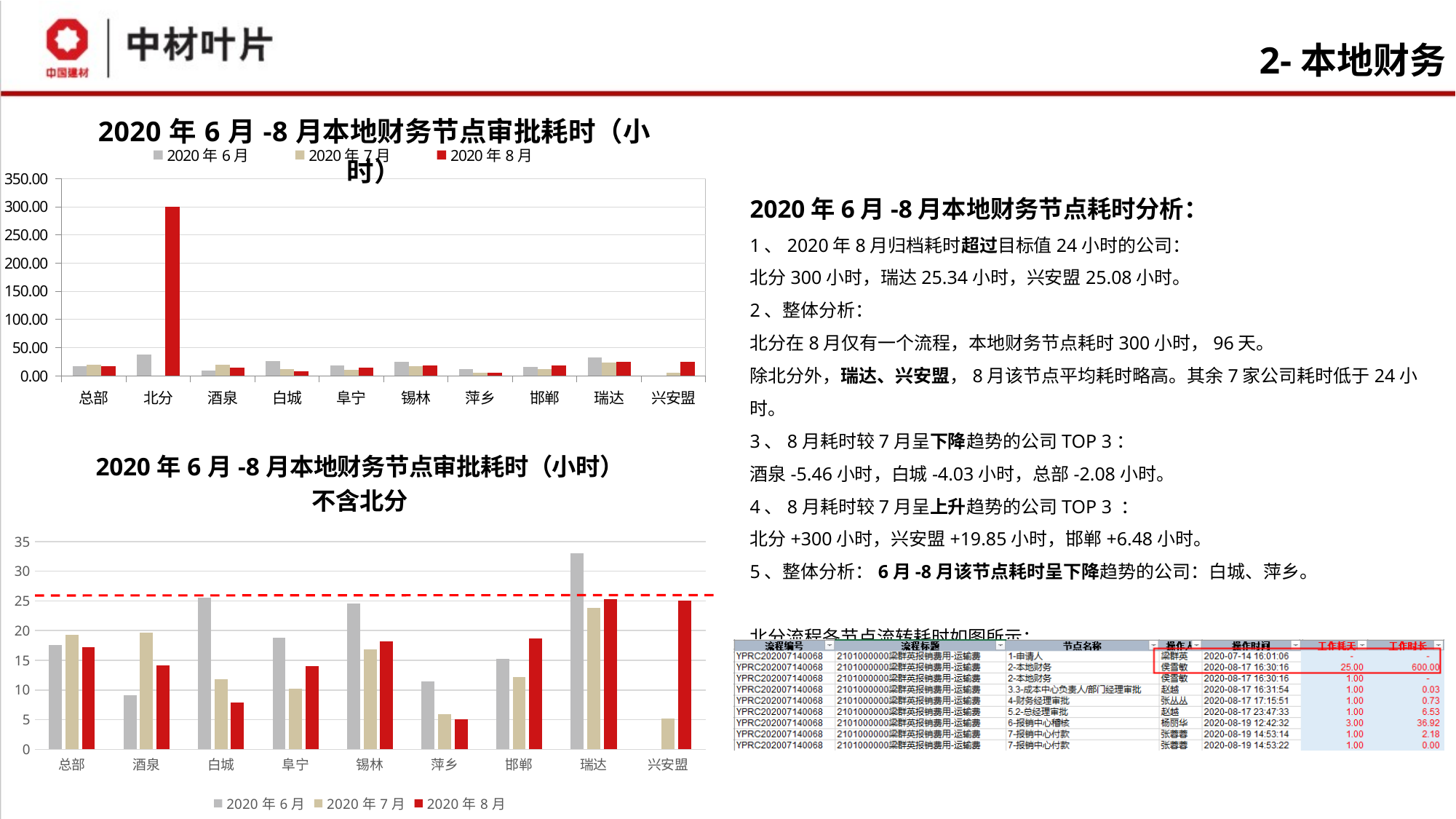
How many categories are shown on the x axis of the bottom chart (不含北分)? 9 In the bottom chart (不含北分), which category has the tallest bar overall? 瑞达 How many categories are shown on the x axis of the top chart? 10 In the bottom chart (不含北分), do the values for 白城 rise or fall from 2020年6月 to 2020年8月? fall In the bottom chart (不含北分), which is larger for 白城: the 2020年6月 value or the 2020年8月 value? 2020年6月 In the bottom chart (不含北分), is the 2020年6月 value for 瑞达 greater or less than 30? greater In the bottom chart (不含北分), is the 2020年8月 value for 白城 greater or less than 10? less In the top chart, what is the value for 北分 in the 2020年8月 series? 300.00 What colour is the dashed horizontal reference line in the bottom chart (不含北分)? red How many series does the legend of the top chart list? 3 In the top chart, which category has the highest bar? 北分 What kind of chart is the top chart titled 2020年6月-8月本地财务节点审批耗时（小时）? bar chart